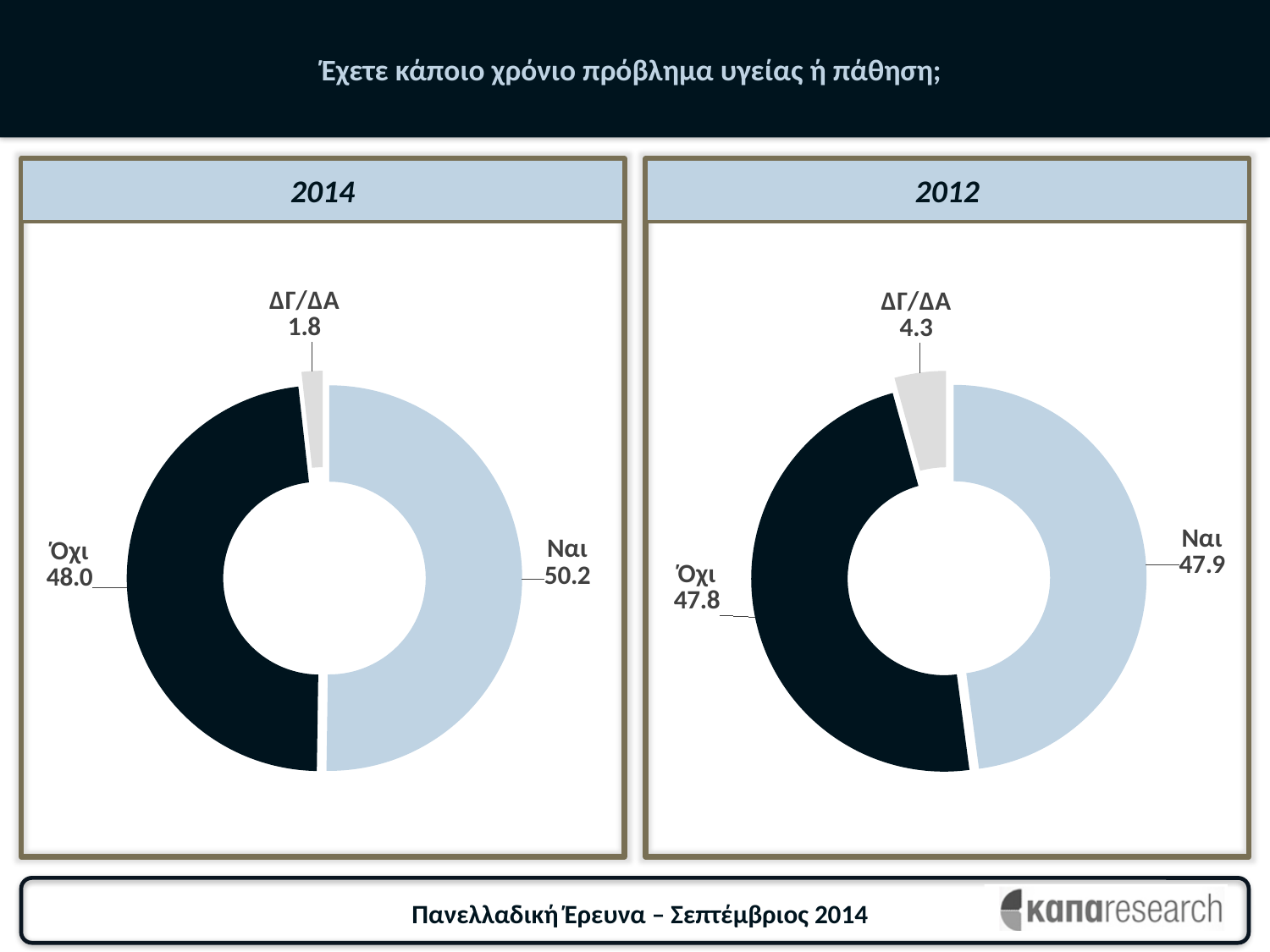
In the 2014 chart, which category has the largest value? Ναι In the 2012 chart, what is the value for Ναι? 47.9 In the 2014 chart, what is the value for Όχι? 48.0 In the 2012 chart, what is the value for ΔΓ/ΔΑ? 4.3 What colour is the Όχι segment in the 2012 chart? Dark navy/black Which is larger: ΔΓ/ΔΑ in the 2014 chart or ΔΓ/ΔΑ in the 2012 chart? 2012 In the 2014 chart, what is the value for Ναι? 50.2 How many categories does the 2012 chart show? 3 In the 2012 chart, what is the difference between Όχι and ΔΓ/ΔΑ? 43.5 What kind of chart is the 2014 chart? Doughnut chart In the 2014 chart, which category has the smallest value? ΔΓ/ΔΑ In the 2014 chart, what is the difference between Ναι and Όχι? 2.2